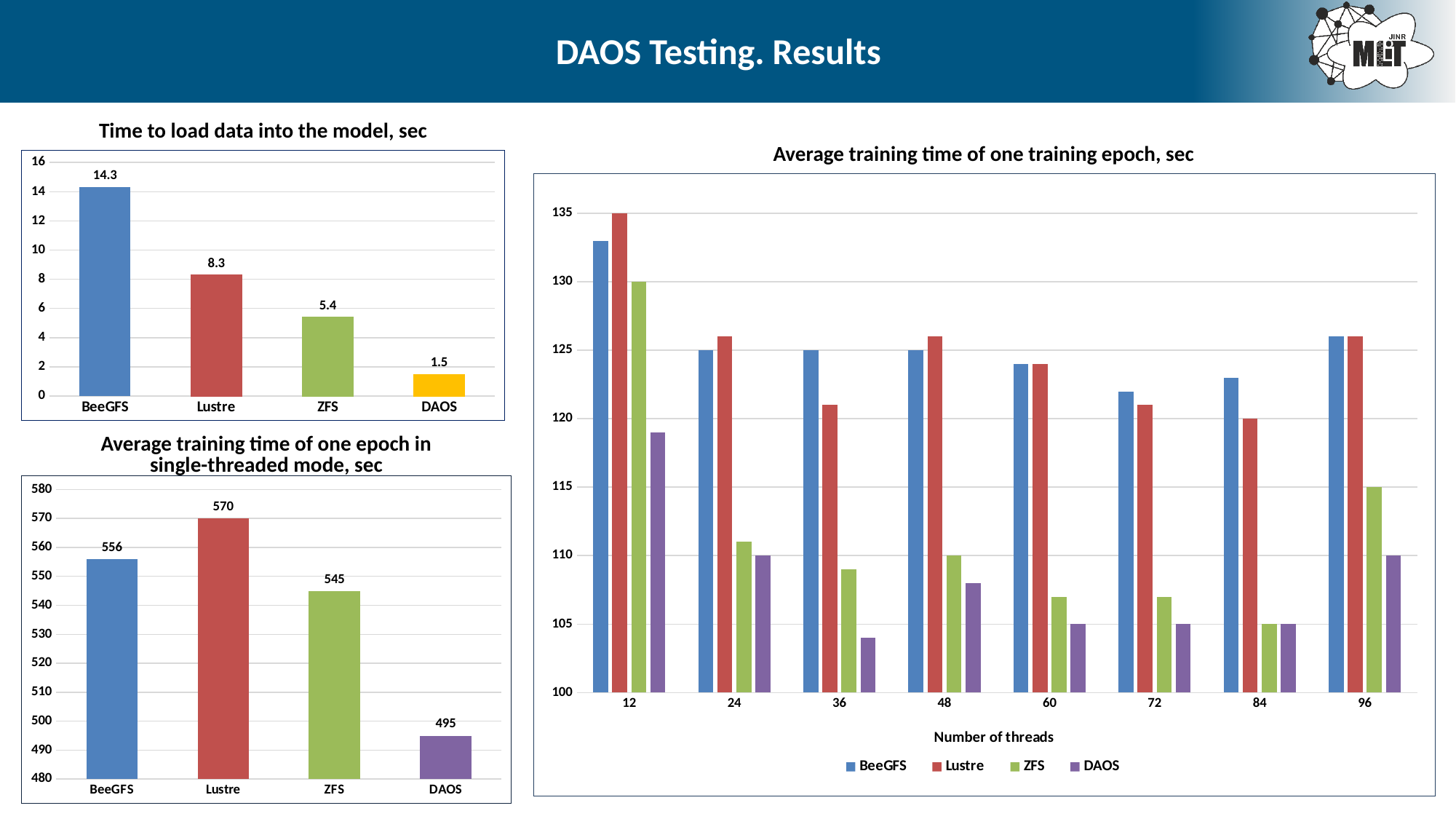
What kind of chart is 'Time to load data into the model, sec'? bar chart In the chart 'Average training time of one epoch in single-threaded mode, sec', which category has the highest value? Lustre In the chart 'Average training time of one epoch in single-threaded mode, sec', what is the difference between the Lustre and DAOS values? 75 In the chart 'Average training time of one epoch in single-threaded mode, sec', which is larger, the value for BeeGFS or the value for ZFS? BeeGFS In the chart 'Average training time of one epoch in single-threaded mode, sec', what is the value for DAOS? 495 In the chart 'Time to load data into the model, sec', what is the difference between the Lustre and ZFS values? 2.9 In the chart 'Average training time of one training epoch, sec', how many thread-count categories are shown on the x axis? 8 In the chart 'Time to load data into the model, sec', what is the value for BeeGFS? 14.3 In the chart 'Time to load data into the model, sec', which category has the lowest value? DAOS In the chart 'Average training time of one training epoch, sec', is the value for ZFS at 60 threads greater or less than 110? less In the chart 'Average training time of one training epoch, sec', is the value for Lustre at 12 threads greater or less than 130? greater In the chart 'Average training time of one training epoch, sec', how many series does the legend list? 4